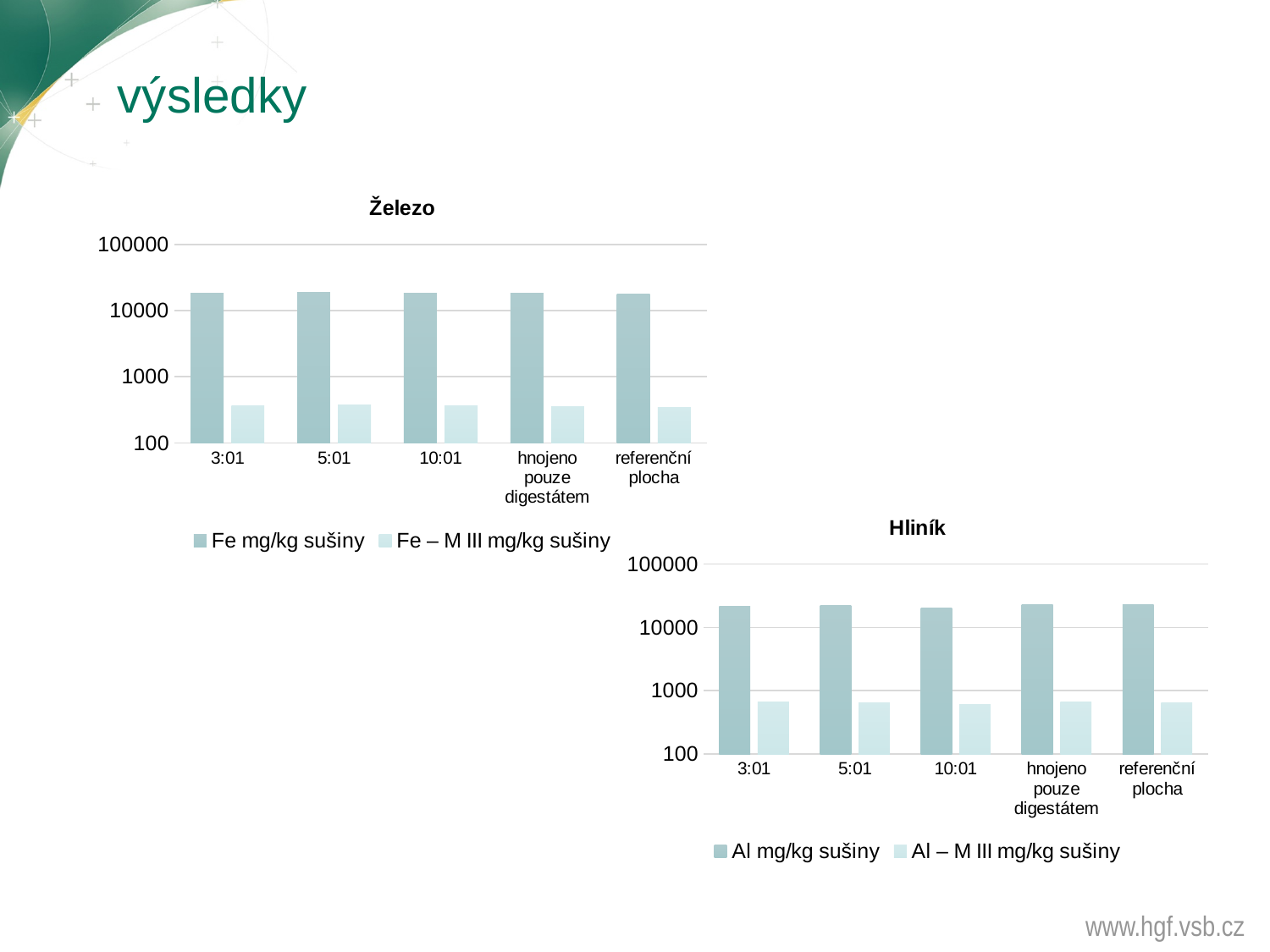
What is the title of the chart in the lower right of the slide? Hliník How many categories are shown on the x axis of the "Hliník" chart? 5 In the "Železo" chart, is the value of "Fe mg/kg sušiny" for 3:01 greater or less than 10000? greater In the "Železo" chart, is the value of "Fe – M III mg/kg sušiny" for 5:01 greater or less than 1000? less In the "Hliník" chart, is the value of "Al mg/kg sušiny" for referenční plocha greater or less than 10000? greater How many series does the legend of the "Železo" chart list? 2 What are the two legend entries of the "Hliník" chart? Al mg/kg sušiny; Al – M III mg/kg sušiny In the "Hliník" chart, which is larger for 3:01: "Al mg/kg sušiny" or "Al – M III mg/kg sušiny"? Al mg/kg sušiny In the "Železo" chart, which is larger for "hnojeno pouze digestátem": "Fe mg/kg sušiny" or "Fe – M III mg/kg sušiny"? Fe mg/kg sušiny What type of chart is the "Železo" chart? bar chart